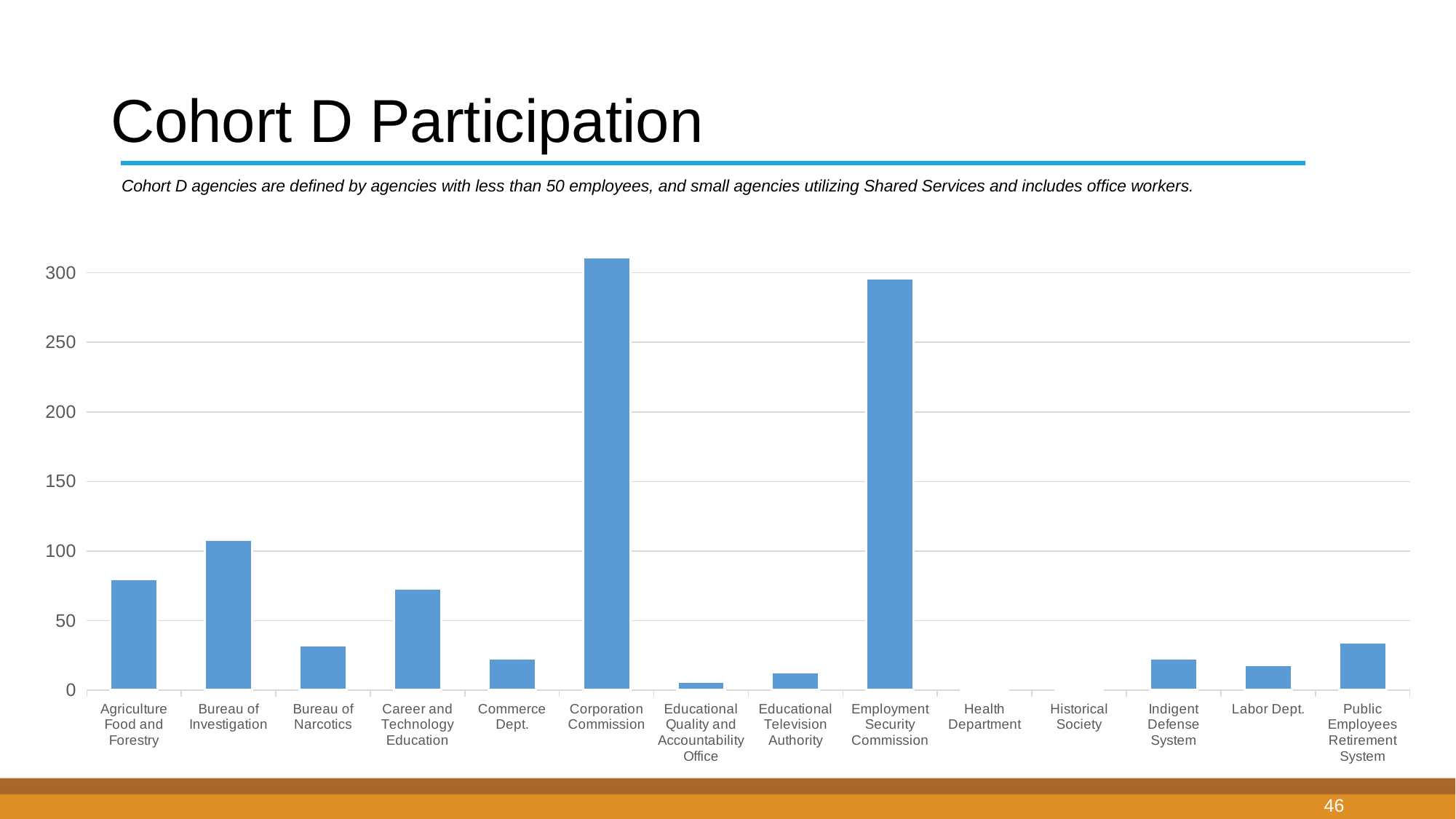
Is the value for Agriculture Food and Forestry greater or less than 100? less Is the value for Commerce Dept. greater or less than 50? less Is the value for Bureau of Investigation greater or less than 100? greater Which is larger, the value for Educational Television Authority or the value for Educational Quality and Accountability Office? Educational Television Authority Which agency has the highest participation in the chart? Corporation Commission What is the title of the slide containing the chart? Cohort D Participation Which is larger, the value for Bureau of Investigation or the value for Agriculture Food and Forestry? Bureau of Investigation What kind of chart is shown on the slide? bar chart How many agencies are listed along the x axis of the chart? 14